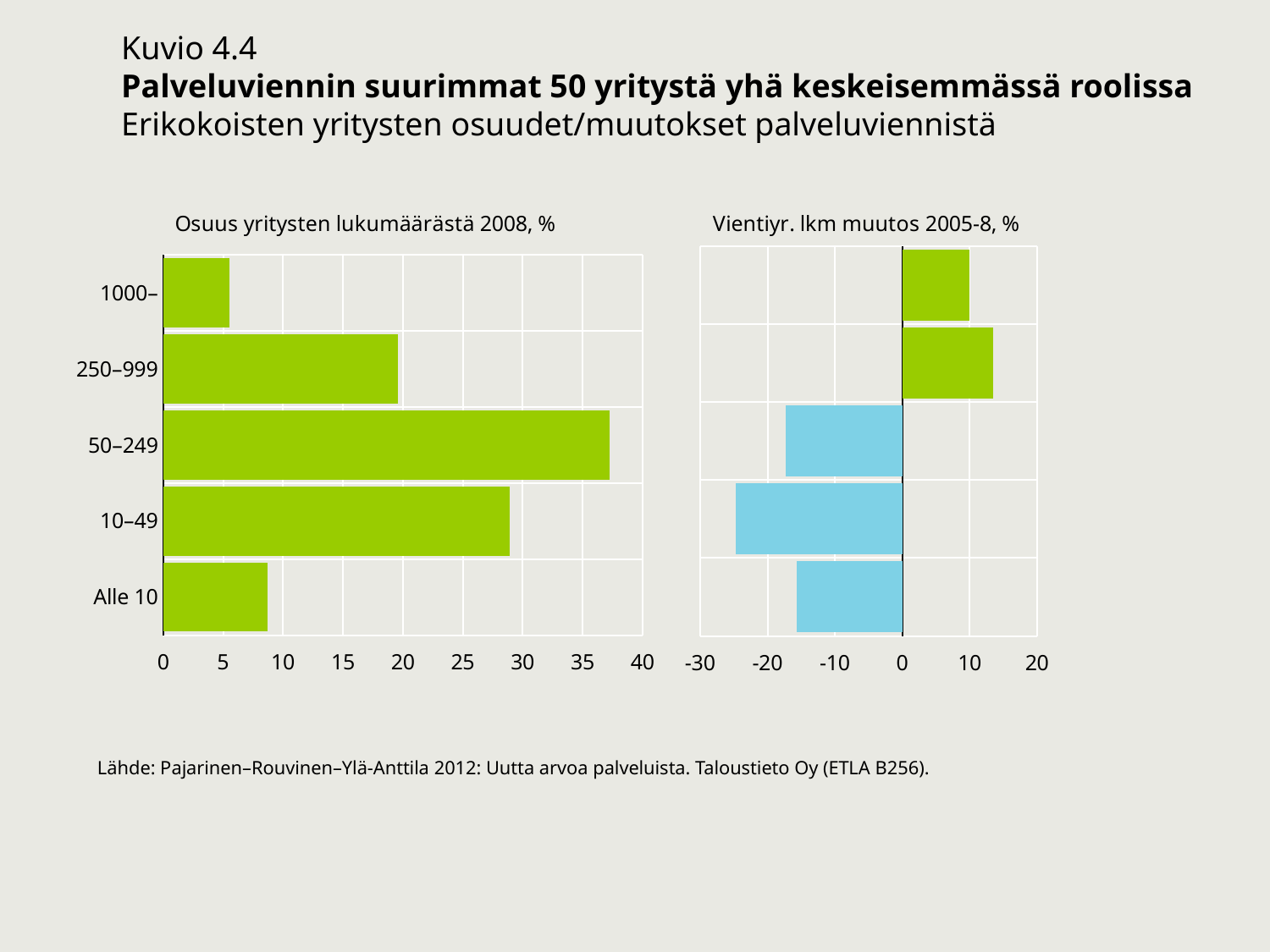
In the left chart (Osuus yritysten lukumäärästä 2008, %), which category has the highest value? 50–249 In the left chart (Osuus yritysten lukumäärästä 2008, %), which category has the lowest value? 1000– In the left chart (Osuus yritysten lukumäärästä 2008, %), is the value for 50–249 greater or less than 35? greater What kind of chart is the right chart (Vientiyr. lkm muutos 2005-8, %)? Bar chart In the right chart (Vientiyr. lkm muutos 2005-8, %), how many categories have negative values? 3 In the right chart (Vientiyr. lkm muutos 2005-8, %), which category has the highest value? 250–999 In the right chart (Vientiyr. lkm muutos 2005-8, %), which category has the lowest value? 10–49 In the left chart (Osuus yritysten lukumäärästä 2008, %), which is larger, the value for 10–49 or the value for Alle 10? 10–49 In the right chart (Vientiyr. lkm muutos 2005-8, %), is the value for 10–49 greater or less than -20? less In the right chart (Vientiyr. lkm muutos 2005-8, %), is the value for 250–999 greater or less than 10? greater How many categories are shown in the left chart (Osuus yritysten lukumäärästä 2008, %)? 5